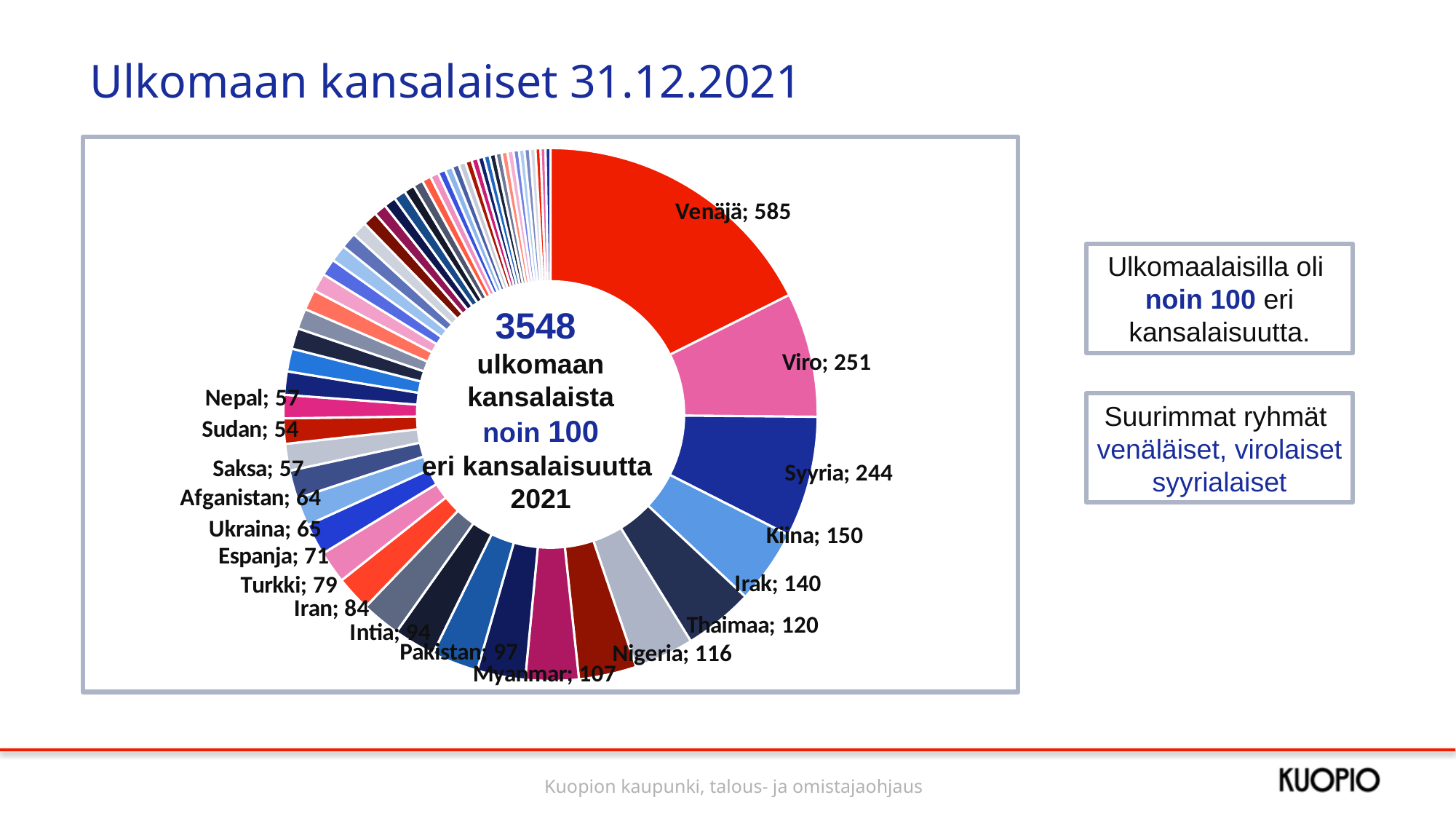
What value is shown for Venäjä in the pie chart? 585 What value is shown for Afganistan in the pie chart? 64 Which country has the largest slice in the pie chart? Venäjä What is the difference between the values for Venäjä and Viro? 334 Which is larger, the value for Iran or the value for Turkki? Iran What kind of chart is shown on the slide? doughnut chart What value is shown for Nigeria in the pie chart? 116 What is the difference between the values for Viro and Syyria? 7 Which is larger, the value for Irak or the value for Thaimaa? Irak What value is shown for Kiina in the pie chart? 150 What value is shown for Viro in the pie chart? 251 What total number of foreign citizens is printed in the centre of the chart? 3548